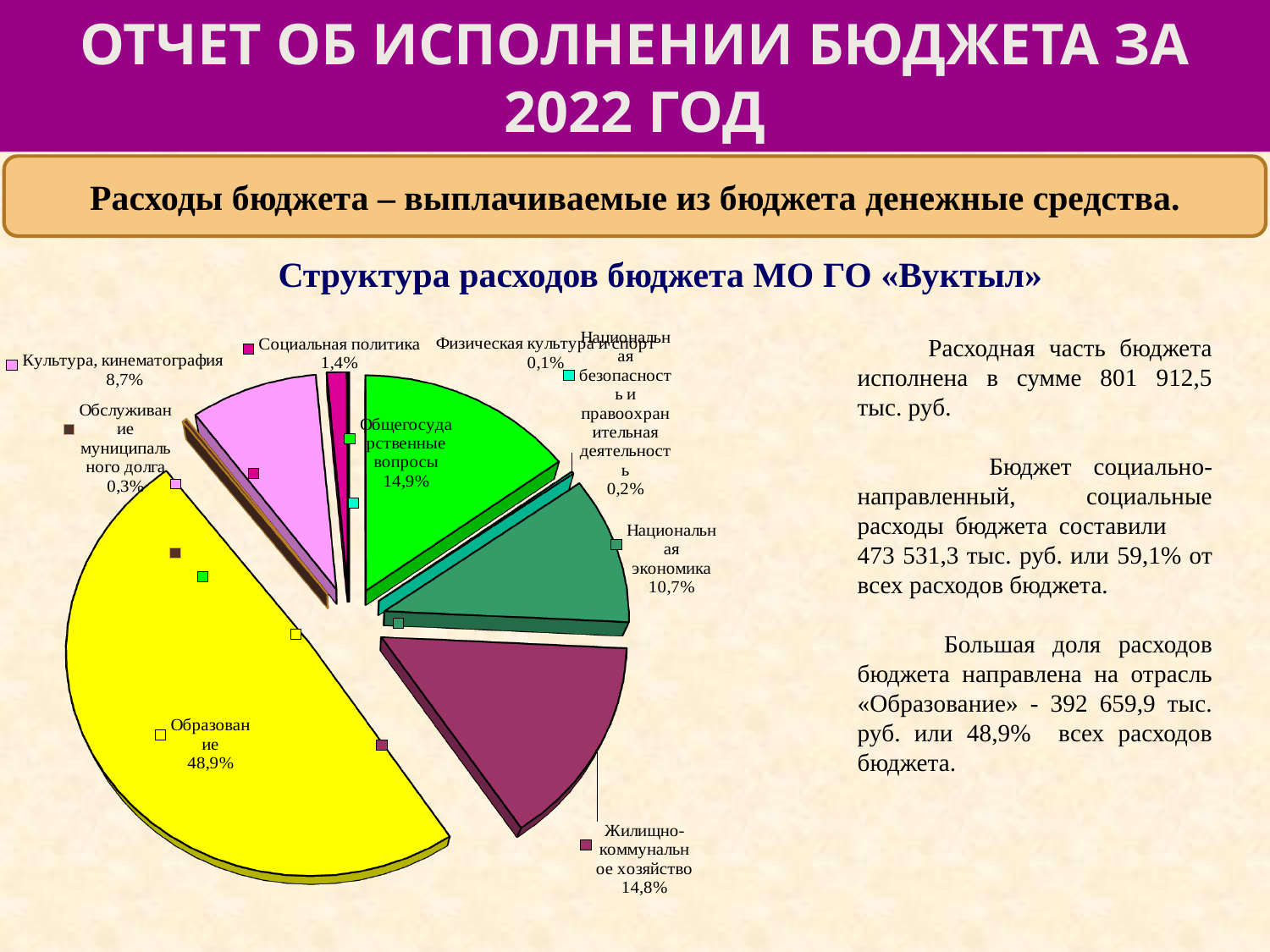
What share of the pie does Жилищно-коммунальное хозяйство have? 14,8% What is the title of the chart? Структура расходов бюджета МО ГО «Вуктыл» Which is larger, the share of Национальная экономика or the share of Культура, кинематография? Национальная экономика What kind of chart is shown on the slide? pie chart What share of the pie does Культура, кинематография have? 8,7% What is the difference between the shares of Образование and Жилищно-коммунальное хозяйство? 34,1% Which category has the smallest share of the pie? Физическая культура и спорт Which category has the largest share of the pie? Образование What share of the pie does Образование have? 48,9% How many categories are shown in the pie chart? 9 What share of the pie does Национальная экономика have? 10,7% What share of the pie does Социальная политика have? 1,4%